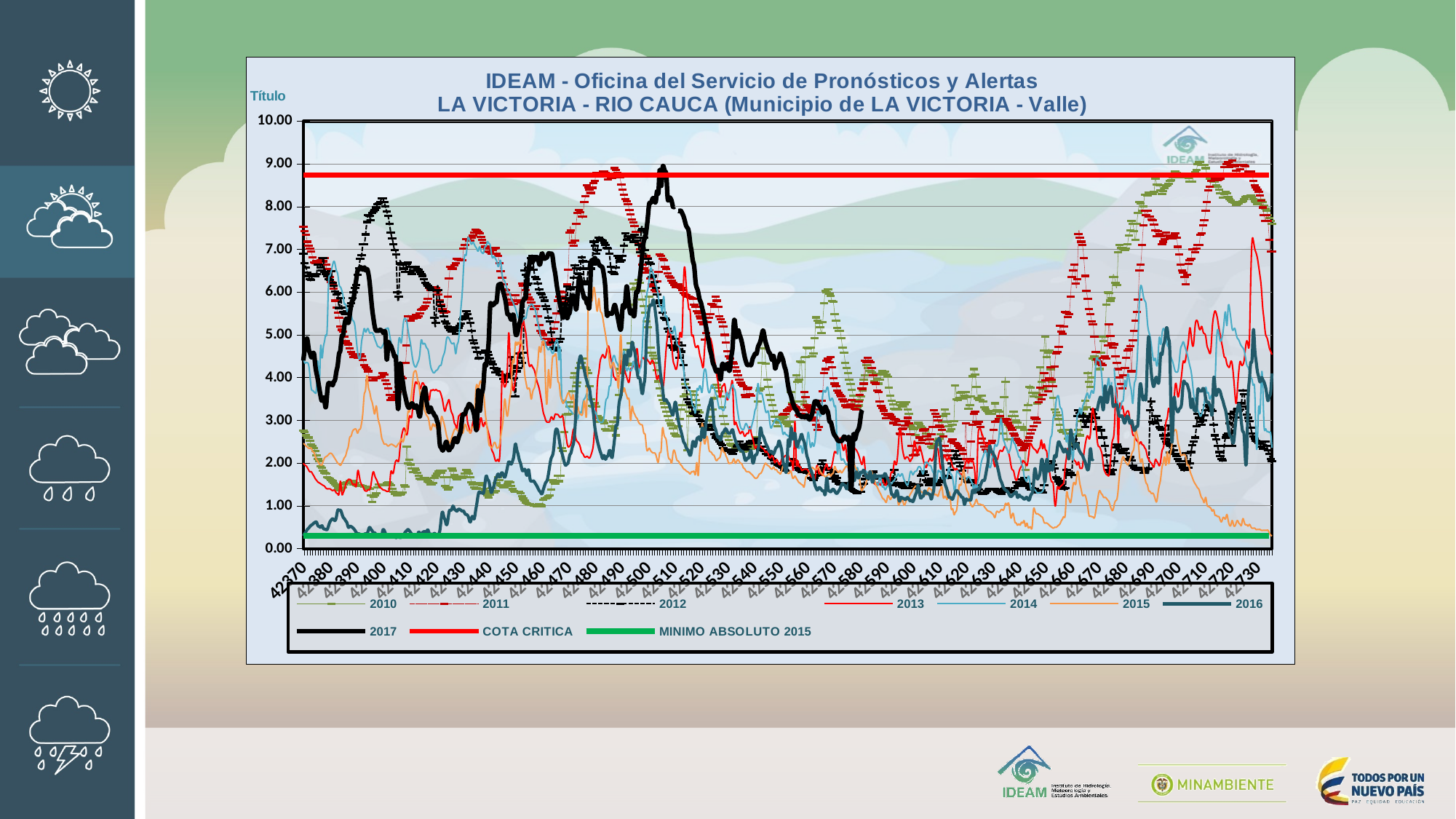
Does the 2017 series rise or fall between 42500 and 42580? fall What kind of chart is shown on the slide? line chart What is the highest value shown on the y axis? 10.00 What is the second line of the chart title? LA VICTORIA - RIO CAUCA (Municipio de LA VICTORIA - Valle) What is the first label on the x axis? 42370 Is the MINIMO ABSOLUTO 2015 line greater or less than 1.00? less What colour is the COTA CRITICA line in the legend? red Is the peak of the 2017 series near 42500 greater or less than 8.00? greater Is the COTA CRITICA line greater or less than 8.00? greater What is the last label on the x axis? 42730 How many series does the chart legend list? 10 Which horizontal reference line is higher, COTA CRITICA or MINIMO ABSOLUTO 2015? COTA CRITICA